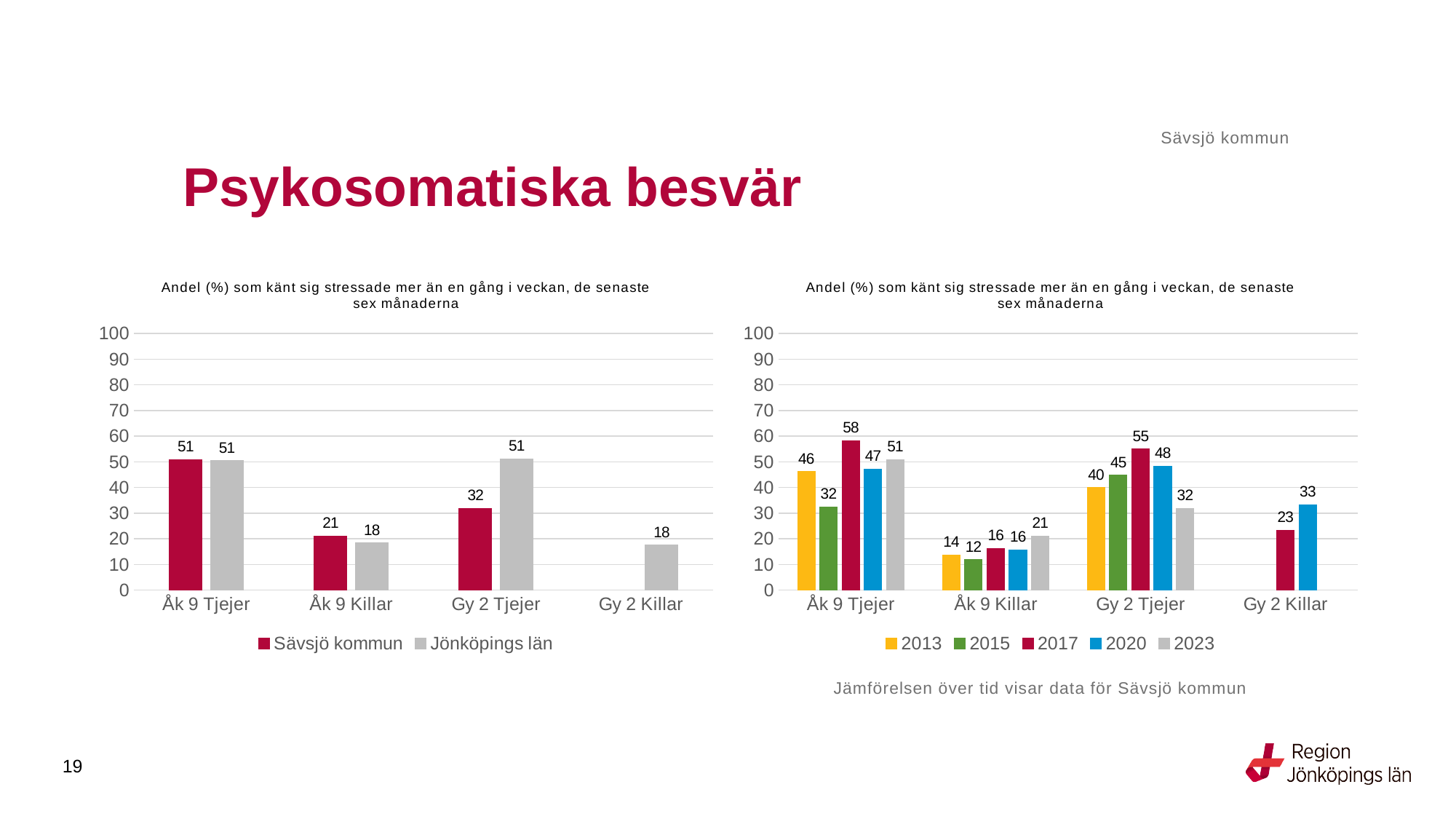
In the left chart, what is the value for Sävsjö kommun for Åk 9 Killar? 21 In the right chart, what is the difference between the 2017 and 2013 values for Åk 9 Tjejer? 12 What type of chart is the right chart? Bar chart In the right chart, which year has the lowest value for Åk 9 Killar? 2015 In the left chart, what is the value for Jönköpings län for Gy 2 Tjejer? 51 In the right chart, what is the value for 2020 for Gy 2 Killar? 33 In the left chart, what is the difference between Jönköpings län and Sävsjö kommun for Gy 2 Tjejer? 19 In the left chart, how many series does the legend list? 2 In the right chart, which year has the highest value for Gy 2 Tjejer? 2017 In the right chart, how many series does the legend list? 5 In the right chart, what is the value for 2017 for Åk 9 Tjejer? 58 In the left chart, which is larger for Åk 9 Killar: Sävsjö kommun or Jönköpings län? Sävsjö kommun